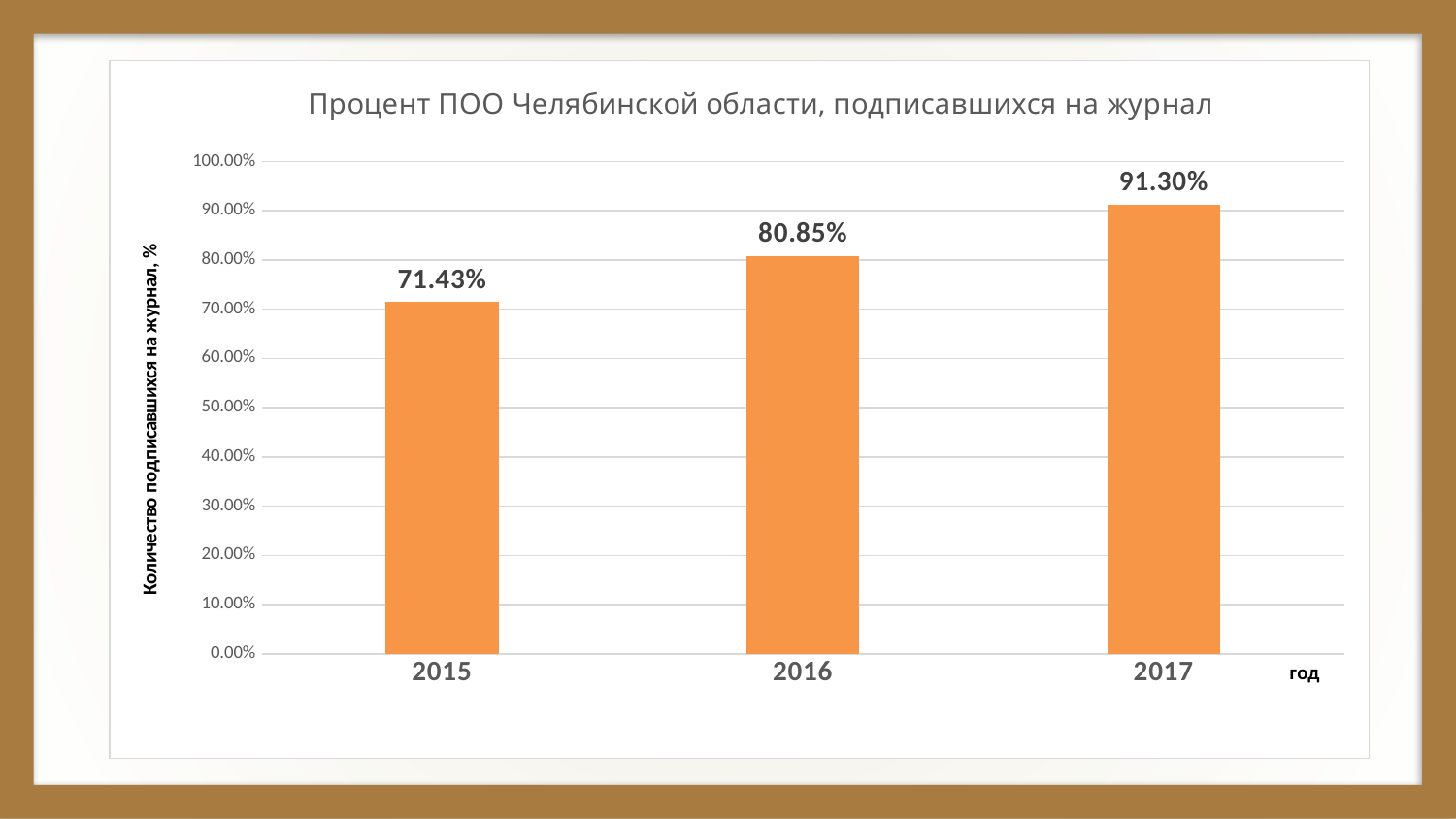
What is the value for 2015? 71.43% Which year has the highest value? 2017 Which is larger, the value for 2016 or the value for 2017? 2017 Do the values rise or fall from 2015 to 2017? rise What is the value for 2016? 80.85% What is the difference between the values for 2017 and 2015? 19.87% What is the value for 2017? 91.30% How many years are shown on the x axis? 3 Which year has the lowest value? 2015 What kind of chart is this? bar chart Is the value for 2016 greater or less than 80.00%? greater What is the difference between the values for 2016 and 2015? 9.42%